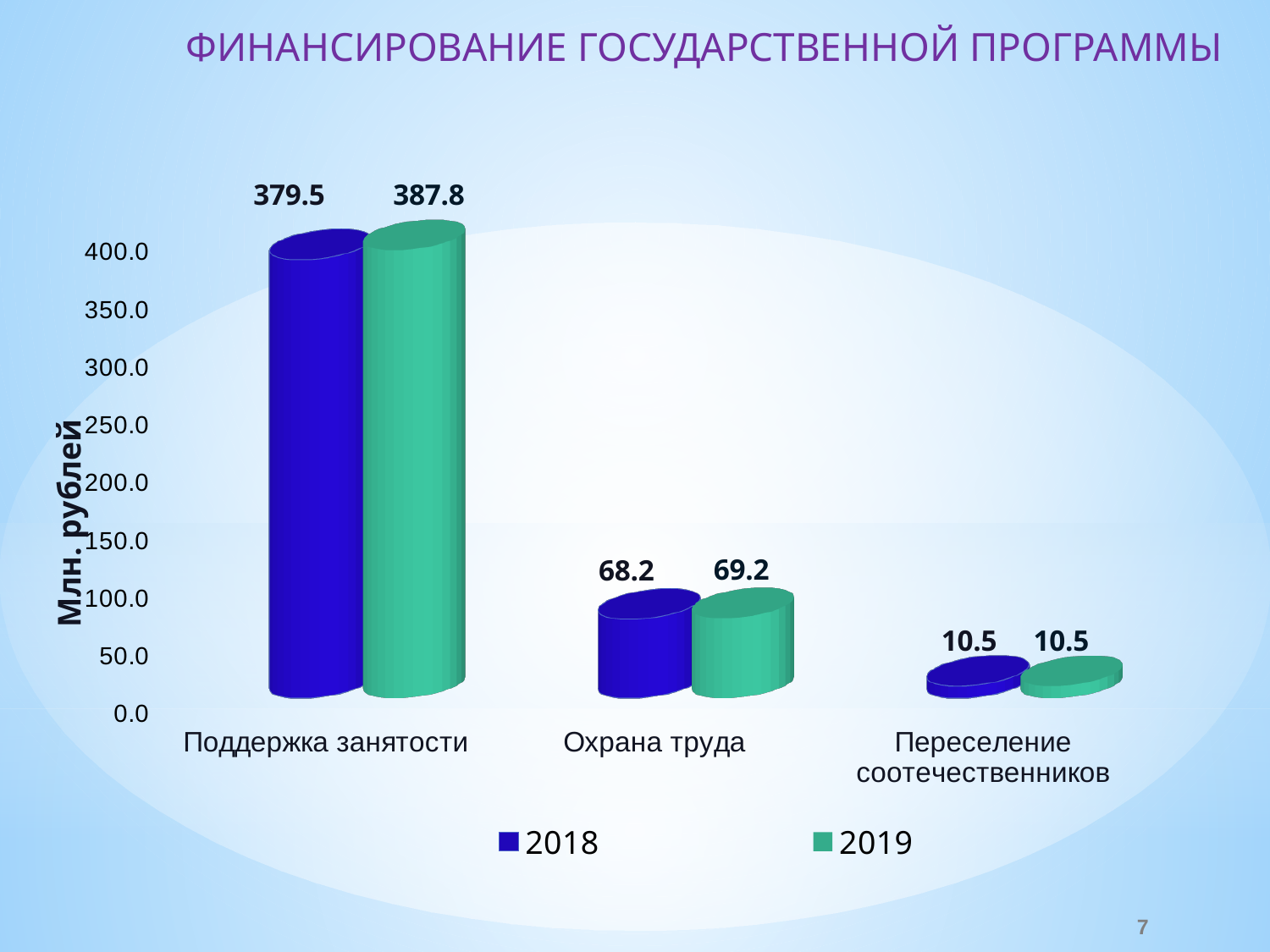
What is the 2019 value for Переселение соотечественников? 10.5 Which category has the lowest 2018 value? Переселение соотечественников What kind of chart is shown on the slide? bar chart What is the 2018 value for Поддержка занятости? 379.5 Is the 2018 value for Охрана труда greater or less than 100.0? less How many series does the legend list? 2 Which category has the highest 2019 value? Поддержка занятости What is the difference between the 2019 and 2018 values for Поддержка занятости? 8.3 What is the difference between the 2019 and 2018 values for Охрана труда? 1.0 What is the 2019 value for Охрана труда? 69.2 Which is larger for Поддержка занятости, the 2018 value or the 2019 value? 2019 How many categories are shown on the x axis? 3